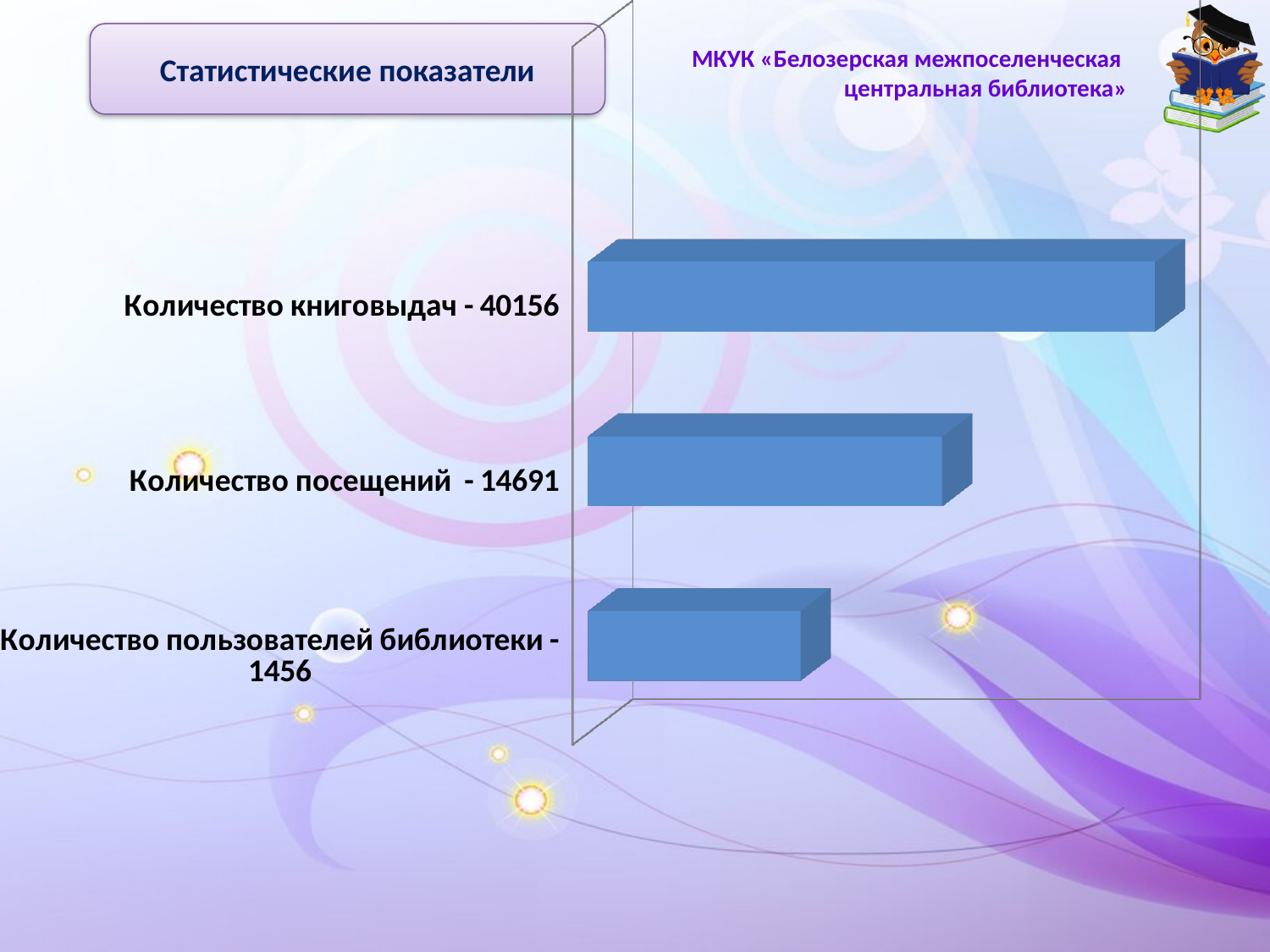
What is the title shown in the box at the top left of the slide? Статистические показатели What is the value for Количество посещений? 14691 What is the value for Количество пользователей библиотеки? 1456 Which category has the highest value? Количество книговыдач Which is larger: Количество посещений or Количество пользователей библиотеки? Количество посещений How many categories does the chart show? 3 What is the value for Количество книговыдач? 40156 What is the difference between Количество посещений and Количество пользователей библиотеки? 13235 What kind of chart is shown on the slide? bar chart What colour are the bars in the chart? blue Which category has the lowest value? Количество пользователей библиотеки What is the difference between Количество книговыдач and Количество посещений? 25465